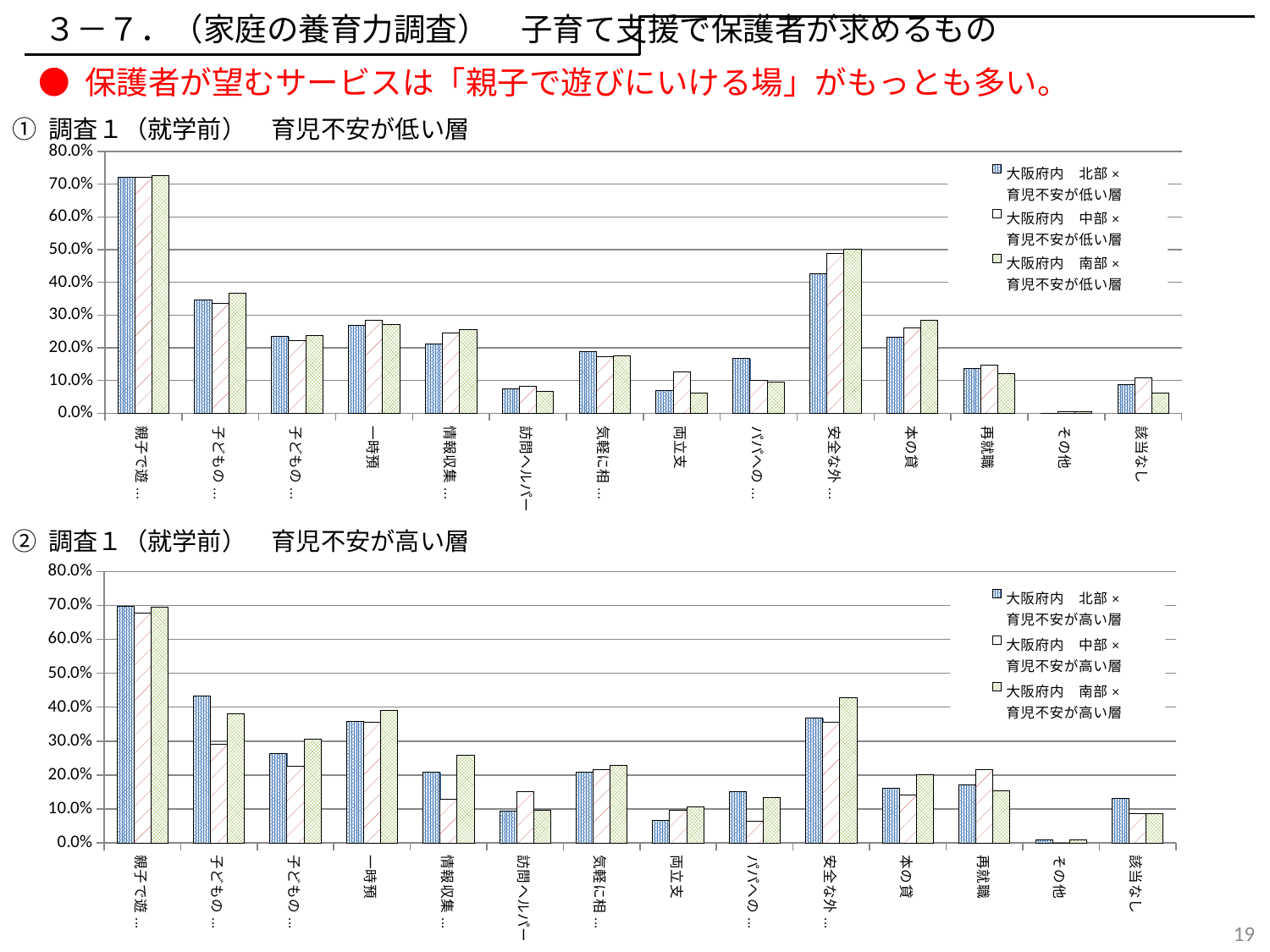
In the bottom chart (育児不安が高い層), for 安全な外…, which series has the larger value: 大阪府内 北部 or 大阪府内 南部? 大阪府内 南部 In the top chart (育児不安が低い層), is the value for 安全な外… in the 大阪府内 南部 series greater or less than 40.0%? greater In the bottom chart (育児不安が高い層), which category has the highest values? 親子で遊… In the bottom chart (育児不安が高い層), is the value for 一時預 in the 大阪府内 北部 series greater or less than 30.0%? greater What kind of chart is the top chart titled 「① 調査１（就学前） 育児不安が低い層」? bar chart In the top chart (育児不安が低い層), is the value for 両立支 in the 大阪府内 中部 series greater or less than 10.0%? greater In the top chart (育児不安が低い層), which category has the lowest values? その他 In the top chart (育児不安が低い層), how many series does the legend list? 3 In the top chart (育児不安が低い層), which category has the highest values? 親子で遊… In the bottom chart (育児不安が高い層), what are the three legend entries? 大阪府内 北部×育児不安が高い層, 大阪府内 中部×育児不安が高い層, 大阪府内 南部×育児不安が高い層 In the top chart (育児不安が低い層), how many categories are shown on the x axis? 14 In the bottom chart (育児不安が高い層), for the first 子どもの… category, which series has the larger value: 大阪府内 北部 or 大阪府内 中部? 大阪府内 北部